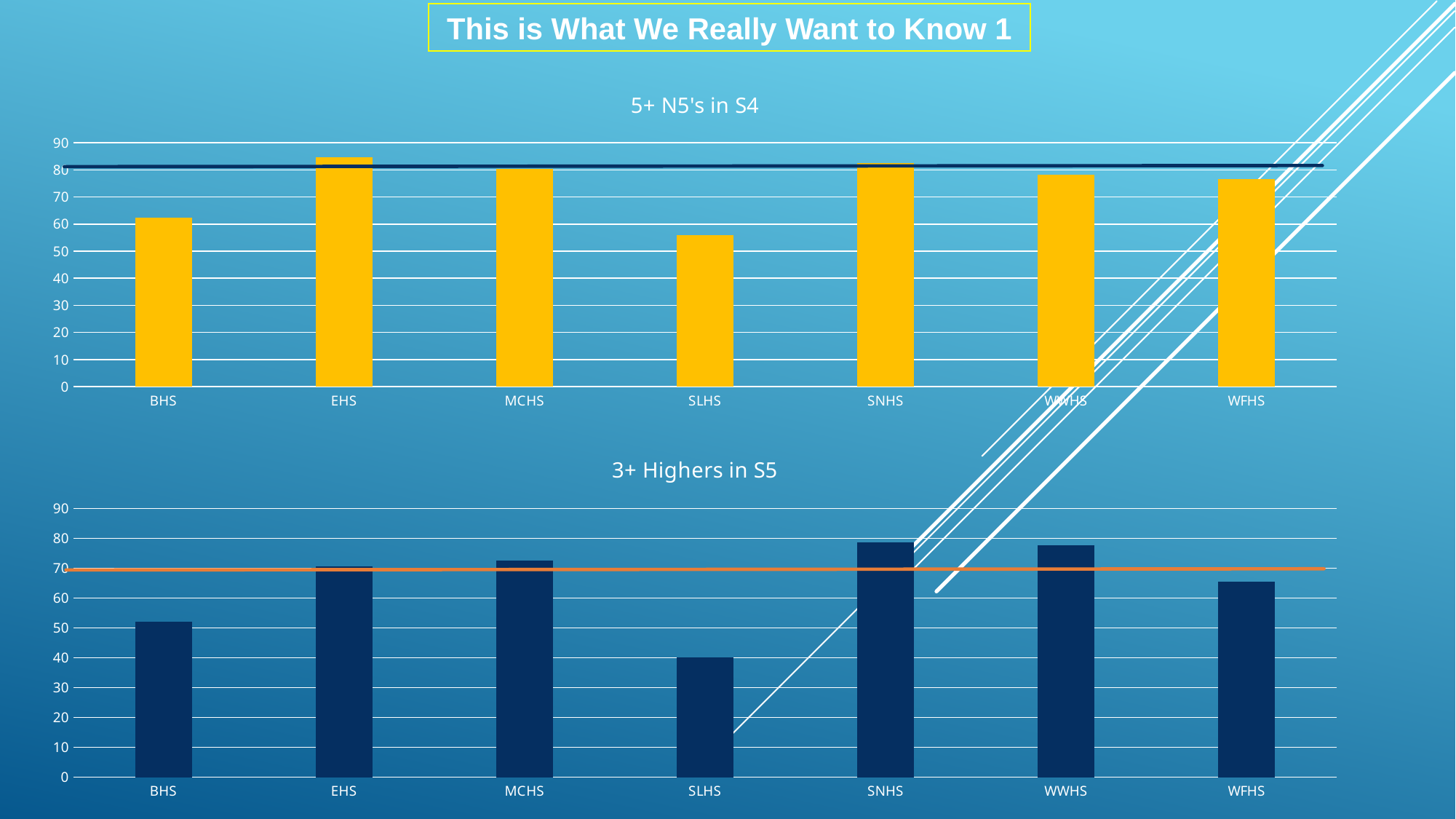
In the '5+ N5's in S4' chart, which is larger, the value for BHS or the value for SLHS? BHS What colour are the bars in the '5+ N5's in S4' chart? yellow In the '5+ N5's in S4' chart, which school has the lowest value? SLHS In the '3+ Highers in S5' chart, is the value for SNHS greater or less than 70? greater In the '3+ Highers in S5' chart, which is larger, the value for MCHS or the value for BHS? MCHS In the '5+ N5's in S4' chart, which school has the highest value? EHS In the '3+ Highers in S5' chart, is the value for SLHS greater or less than 50? less In the '5+ N5's in S4' chart, is the value for EHS greater or less than 80? greater In the '3+ Highers in S5' chart, which school has the lowest value? SLHS How many schools are shown on the x axis of the '3+ Highers in S5' chart? 7 What kind of chart is the '5+ N5's in S4' chart? bar chart